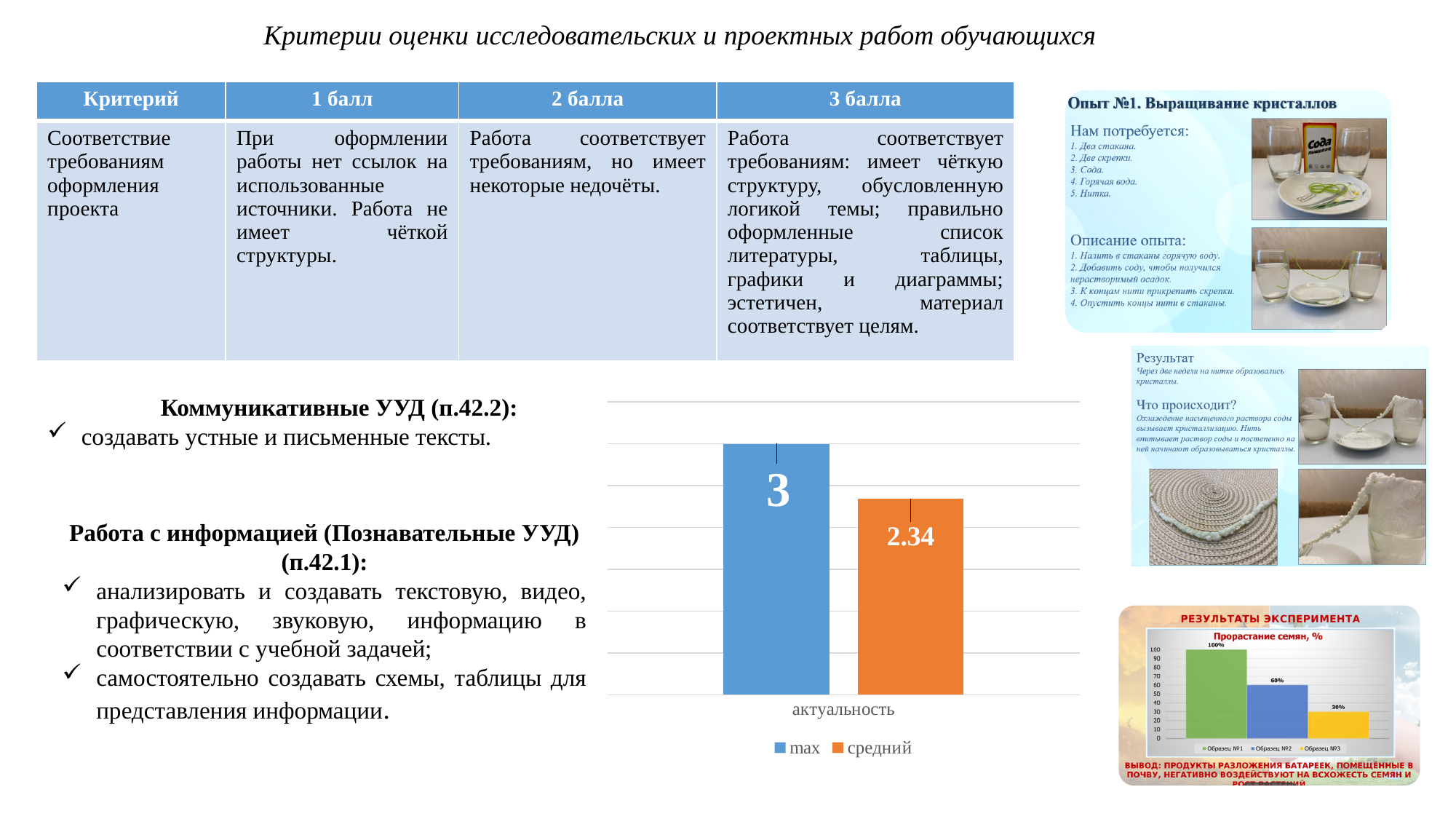
In the chart titled Прорастание семян, % in the bottom-right image, what is the value for Образец №3? 30% In the centre bar chart with the category актуальность, which series has the higher value, max or средний? max In the centre bar chart with the category актуальность, what is the value for the series max? 3 In the chart titled Прорастание семян, % in the bottom-right image, which sample has the lowest value? Образец №3 In the centre bar chart with the category актуальность, what is the value for the series средний? 2.34 In the centre bar chart, what colour is the bar for the series средний? orange How many categories are shown on the x axis of the centre bar chart? 1 What kind of chart is the centre chart with the category актуальность? bar chart In the chart titled Прорастание семян, % in the bottom-right image, what is the difference between Образец №1 and Образец №2? 40% In the chart titled Прорастание семян, % in the bottom-right image, what is the value for Образец №1? 100% How many series does the legend of the centre bar chart list? 2 In the centre bar chart with the category актуальность, what is the difference between the max value and the средний value? 0.66